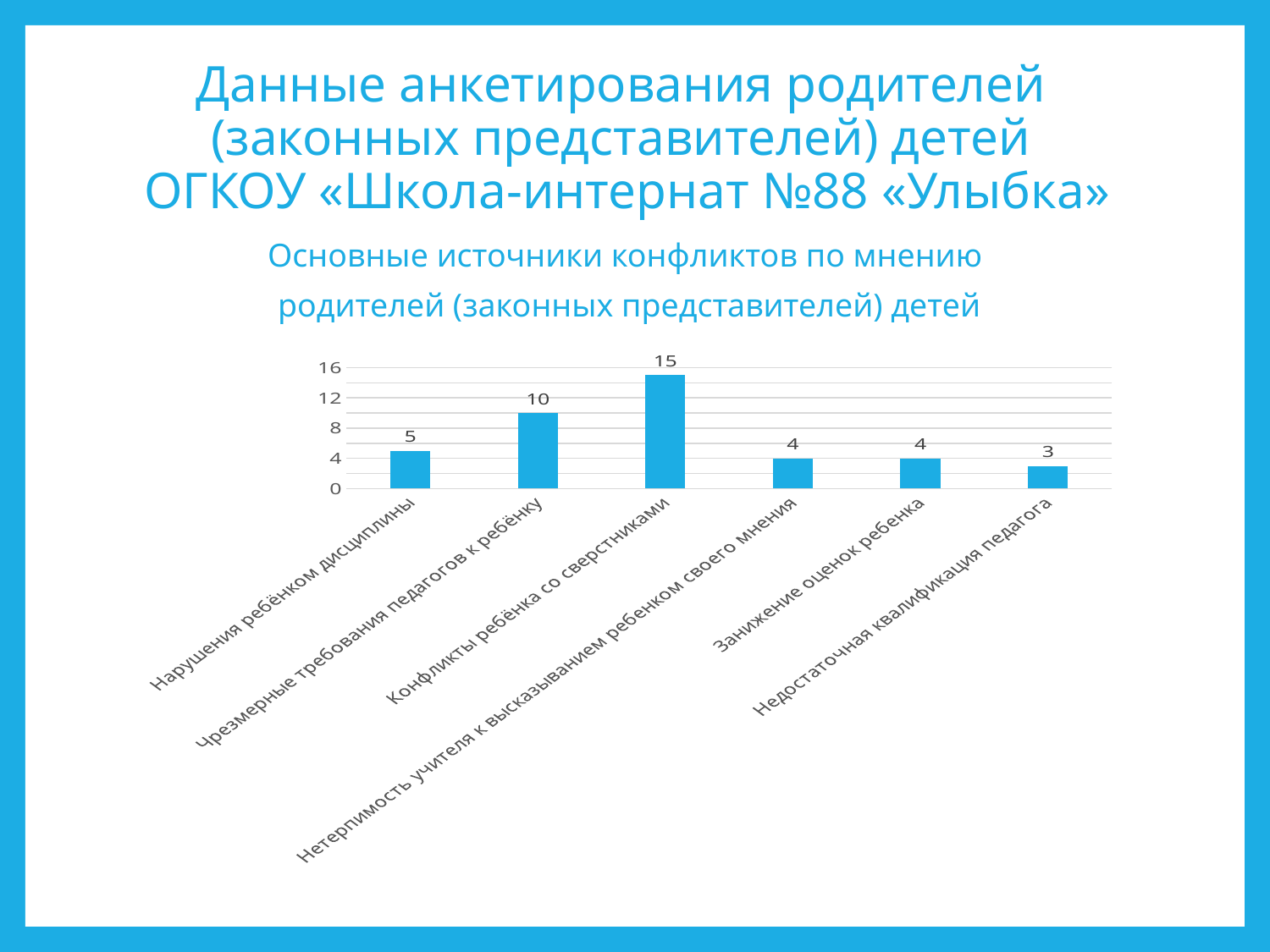
What is the value for «Недостаточная квалификация педагога»? 3 What is the value for «Конфликты ребёнка со сверстниками»? 15 What is the title of the chart? Основные источники конфликтов по мнению родителей (законных представителей) детей Which category has the lowest value? Недостаточная квалификация педагога What is the difference between the values for «Конфликты ребёнка со сверстниками» and «Чрезмерные требования педагогов к ребёнку»? 5 What kind of chart is shown on the slide? bar chart Is the value for «Чрезмерные требования педагогов к ребёнку» greater or less than 8? greater What is the value for «Чрезмерные требования педагогов к ребёнку»? 10 What is the value for «Нарушения ребёнком дисциплины»? 5 How many categories are shown in the chart? 6 Which is larger: the value for «Нарушения ребёнком дисциплины» or the value for «Занижение оценок ребенка»? Нарушения ребёнком дисциплины Which category has the highest value? Конфликты ребёнка со сверстниками